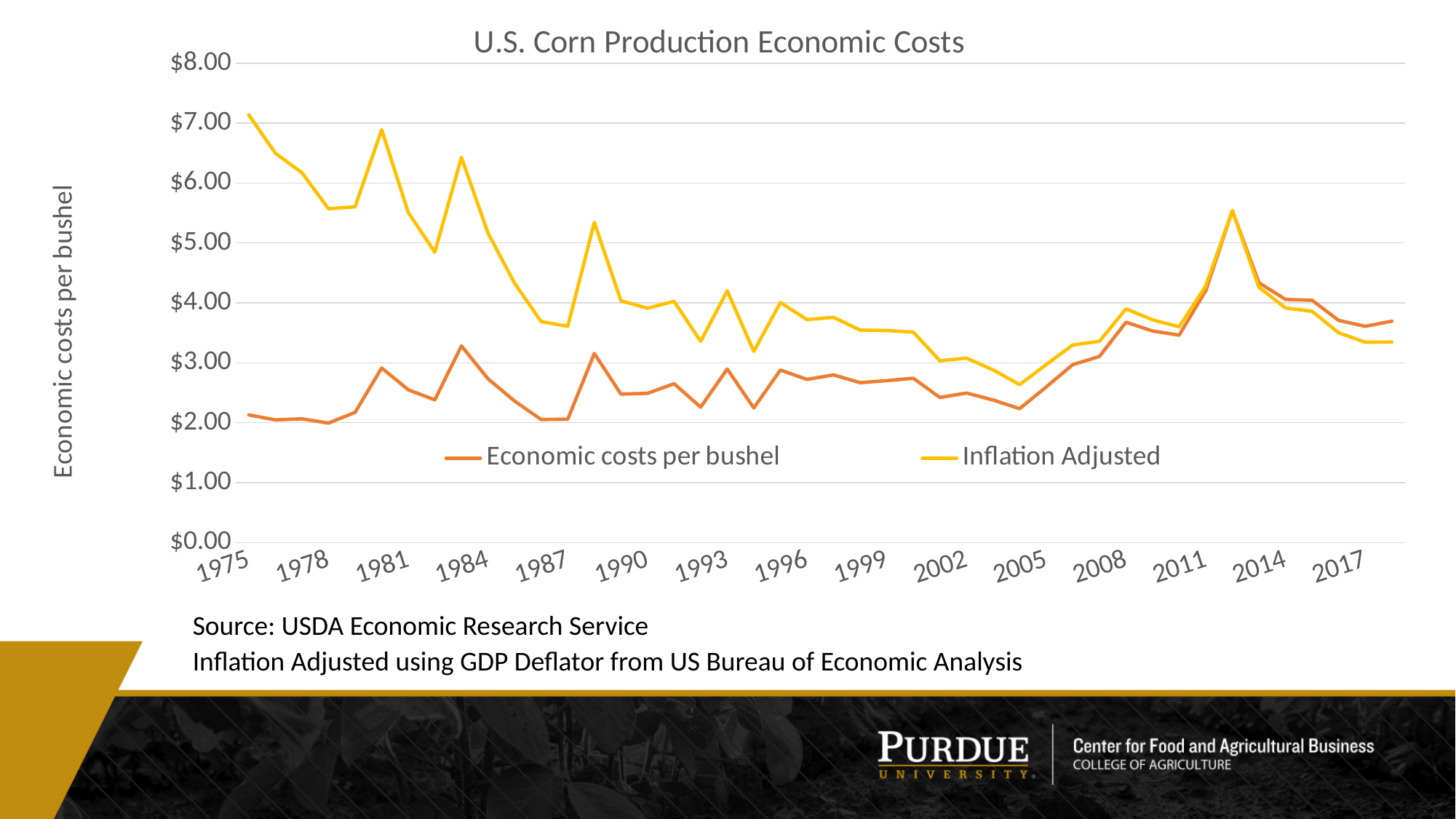
Is the Economic costs per bushel value for 1975 greater or less than $3.00? less In 1975, which series has the higher value, Economic costs per bushel or Inflation Adjusted? Inflation Adjusted In which year is the Inflation Adjusted series at its lowest? 2004 Is the Inflation Adjusted value for 1975 greater or less than $6.00? greater Which series is drawn in yellow? Inflation Adjusted How many series does the legend list? 2 Is the Economic costs per bushel value for 2017 greater or less than $3.00? greater Does the Inflation Adjusted series rise or fall from 1975 to 1978? fall What is the title of the chart? U.S. Corn Production Economic Costs In which year is the Inflation Adjusted series at its highest? 1975 What kind of chart is shown on the slide? line chart